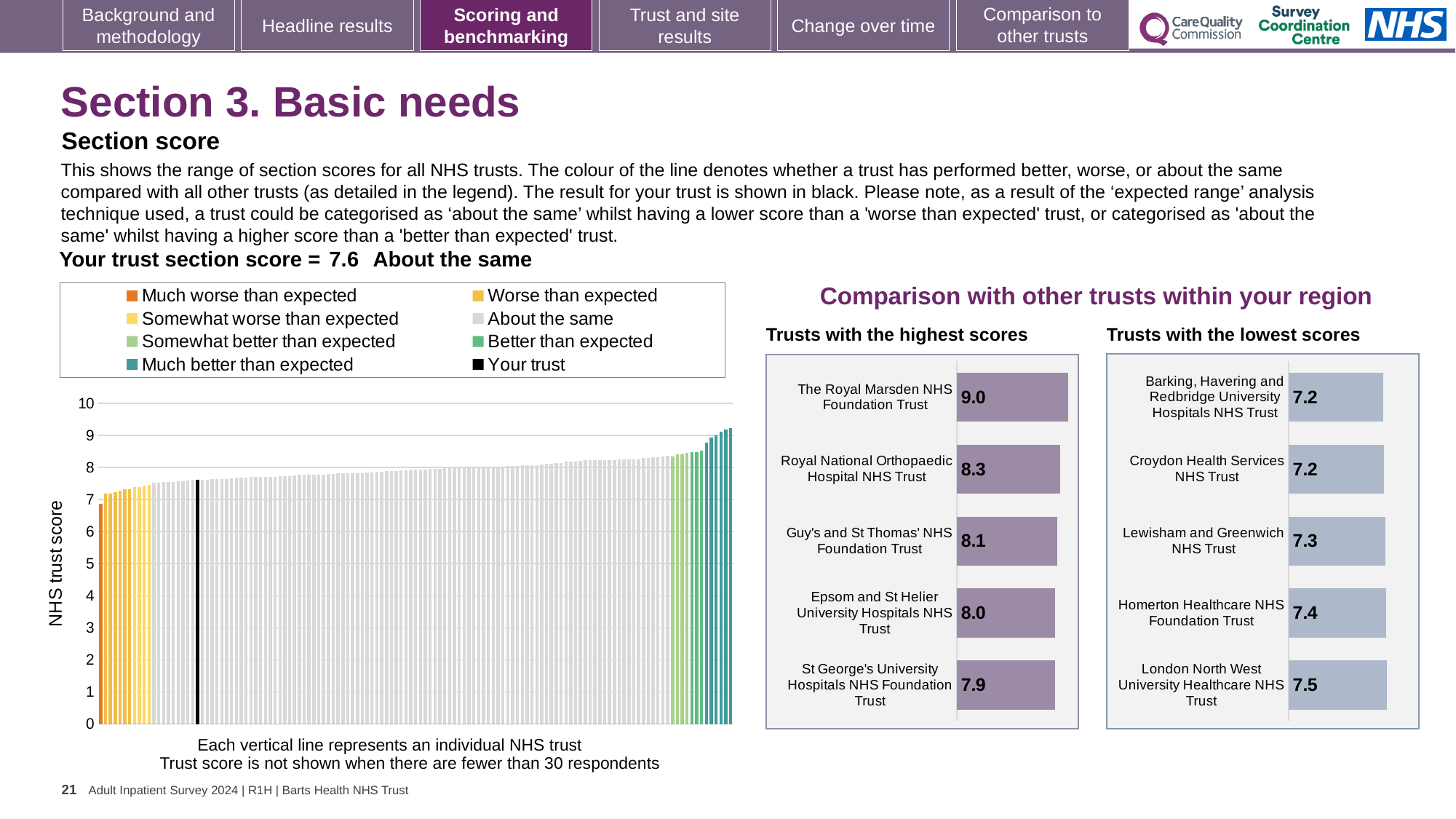
How many entries does the legend of the main 'NHS trust score' chart on the left list? 8 In the main 'NHS trust score' chart on the left, is the value for the black 'Your trust' bar greater or less than 8? less In the 'Trusts with the highest scores' chart, which trust has the lowest score shown? St George's University Hospitals NHS Foundation Trust In the 'Trusts with the highest scores' chart, what is the score for The Royal Marsden NHS Foundation Trust? 9.0 In the 'Trusts with the lowest scores' chart, what is the score for Homerton Healthcare NHS Foundation Trust? 7.4 In the 'Trusts with the highest scores' chart, what is the difference between the scores of The Royal Marsden NHS Foundation Trust and St George's University Hospitals NHS Foundation Trust? 1.1 In the 'Trusts with the highest scores' chart, which has the larger score: Royal National Orthopaedic Hospital NHS Trust or Epsom and St Helier University Hospitals NHS Trust? Royal National Orthopaedic Hospital NHS Trust In the 'Trusts with the lowest scores' chart, what is the difference between the scores of London North West University Healthcare NHS Trust and Croydon Health Services NHS Trust? 0.3 In the 'Trusts with the lowest scores' chart, which trust has the highest score shown? London North West University Healthcare NHS Trust In the 'Trusts with the highest scores' chart, what is the score for Guy's and St Thomas' NHS Foundation Trust? 8.1 In the 'Trusts with the lowest scores' chart, how many trusts are listed? 5 What kind of chart is the 'Trusts with the highest scores' chart? bar chart